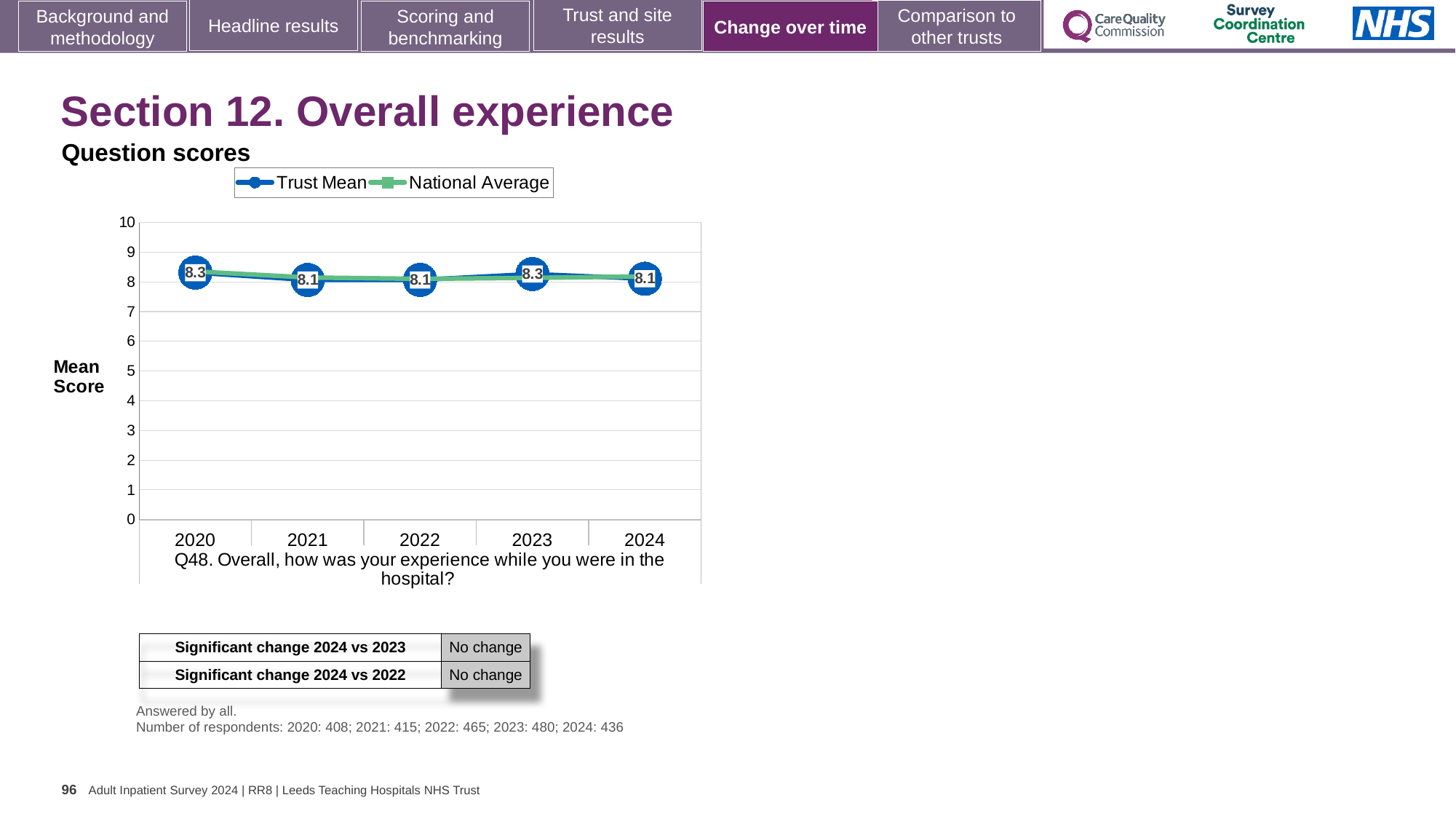
Does the Trust Mean score rise or fall from 2023 to 2024? Fall Is the National Average value for 2022 greater or less than 5? greater How many years are plotted on the x axis? 5 What is the difference between the Trust Mean scores for 2020 and 2021? 0.2 What kind of chart is shown on the slide? Line chart How many series does the legend list? 2 Which year has the larger Trust Mean score, 2023 or 2024? 2023 What is the Trust Mean score for 2021? 8.1 What is the Trust Mean score for 2024? 8.1 What is the Trust Mean score for 2020? 8.3 What is the Trust Mean score for 2023? 8.3 What is the label of the y axis? Mean Score